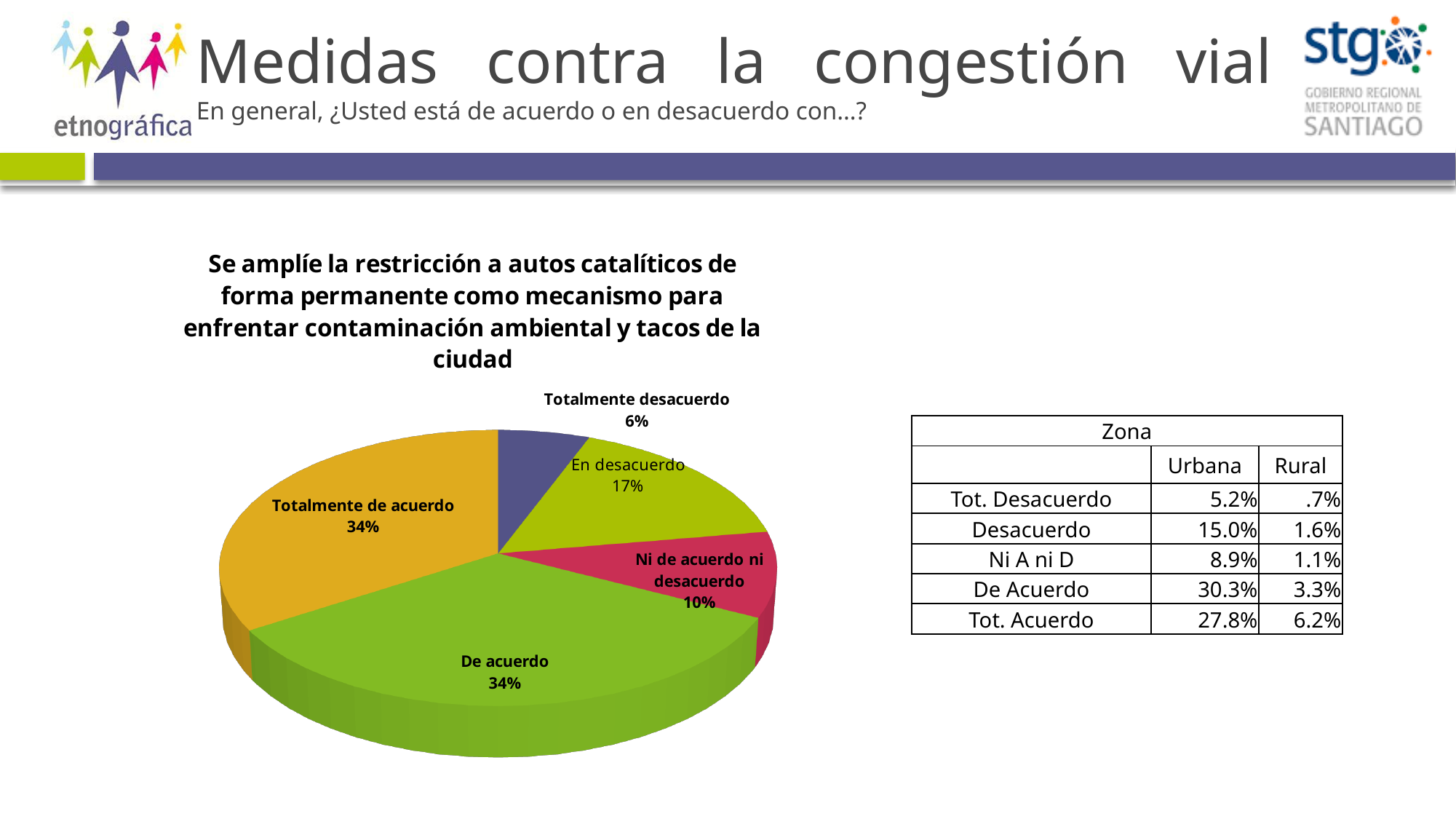
Which category has the smallest slice of the pie? Totalmente desacuerdo What is the value shown for "Ni de acuerdo ni desacuerdo"? 10% How many slices does the pie chart have? 5 What is the difference between the "En desacuerdo" and "Totalmente desacuerdo" slices? 11% What share of the pie does "De acuerdo" represent? 34% What is the value shown for "Totalmente de acuerdo"? 34% What is the value shown for "Totalmente desacuerdo"? 6% What is the value shown for "En desacuerdo"? 17% What is the combined share of "De acuerdo" and "Totalmente de acuerdo"? 68% What colour is the "Totalmente desacuerdo" slice? Purple Which is larger, the "En desacuerdo" slice or the "Ni de acuerdo ni desacuerdo" slice? En desacuerdo What kind of chart is shown on the slide? Pie chart